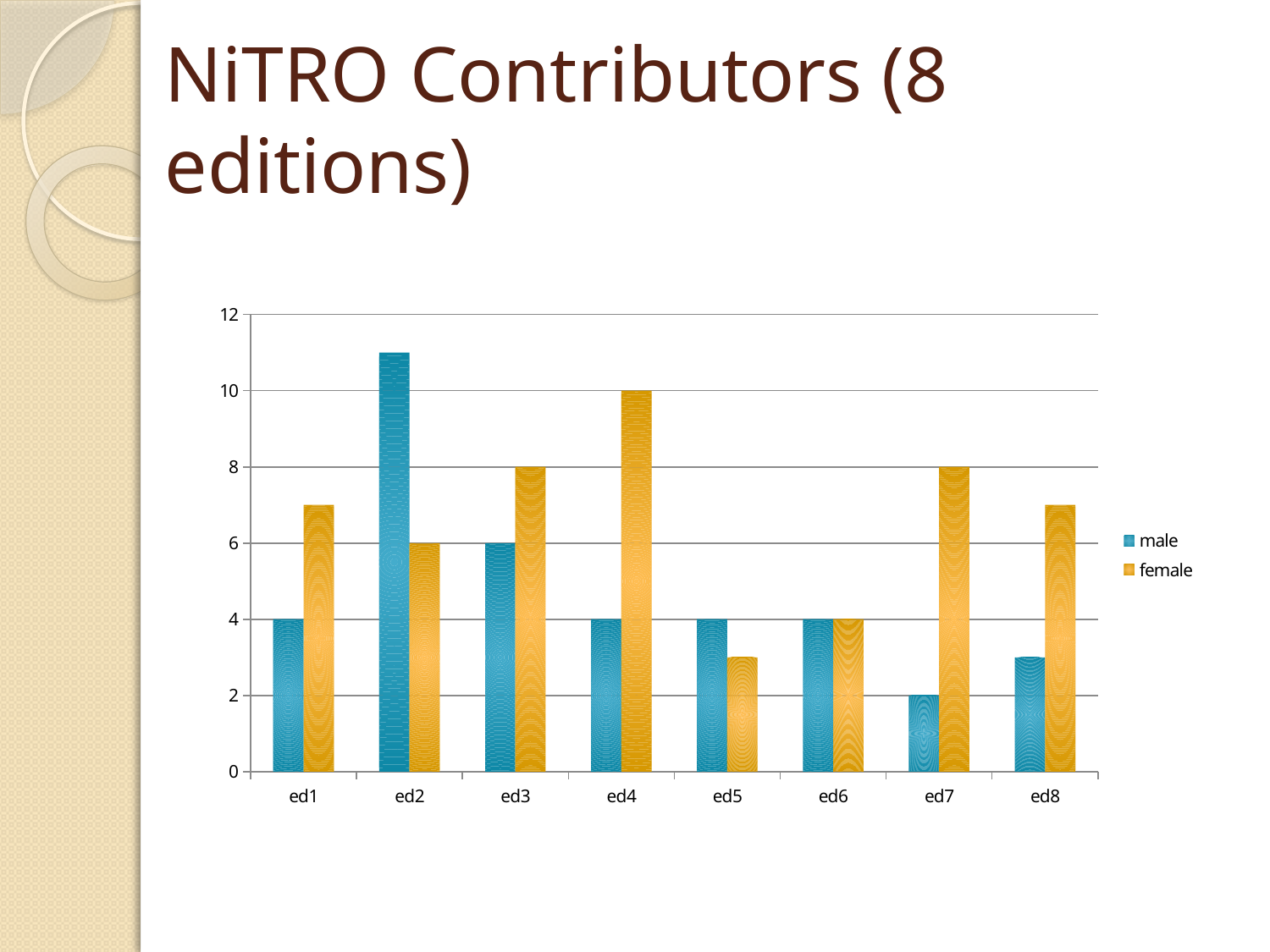
What is the value for female in ed3? 8 Is the value for female in ed1 greater or less than 6? greater In ed2, which is larger, the male or the female value? male What is the difference between the female and male values in ed4? 6 Which edition has the highest male value? ed2 What is the value for male in ed4? 4 How many editions are shown on the x axis? 8 How many series does the legend list? 2 What is the value for female in ed4? 10 What is the value for male in ed7? 2 What kind of chart is shown on the slide? bar chart Which edition has the lowest female value? ed5